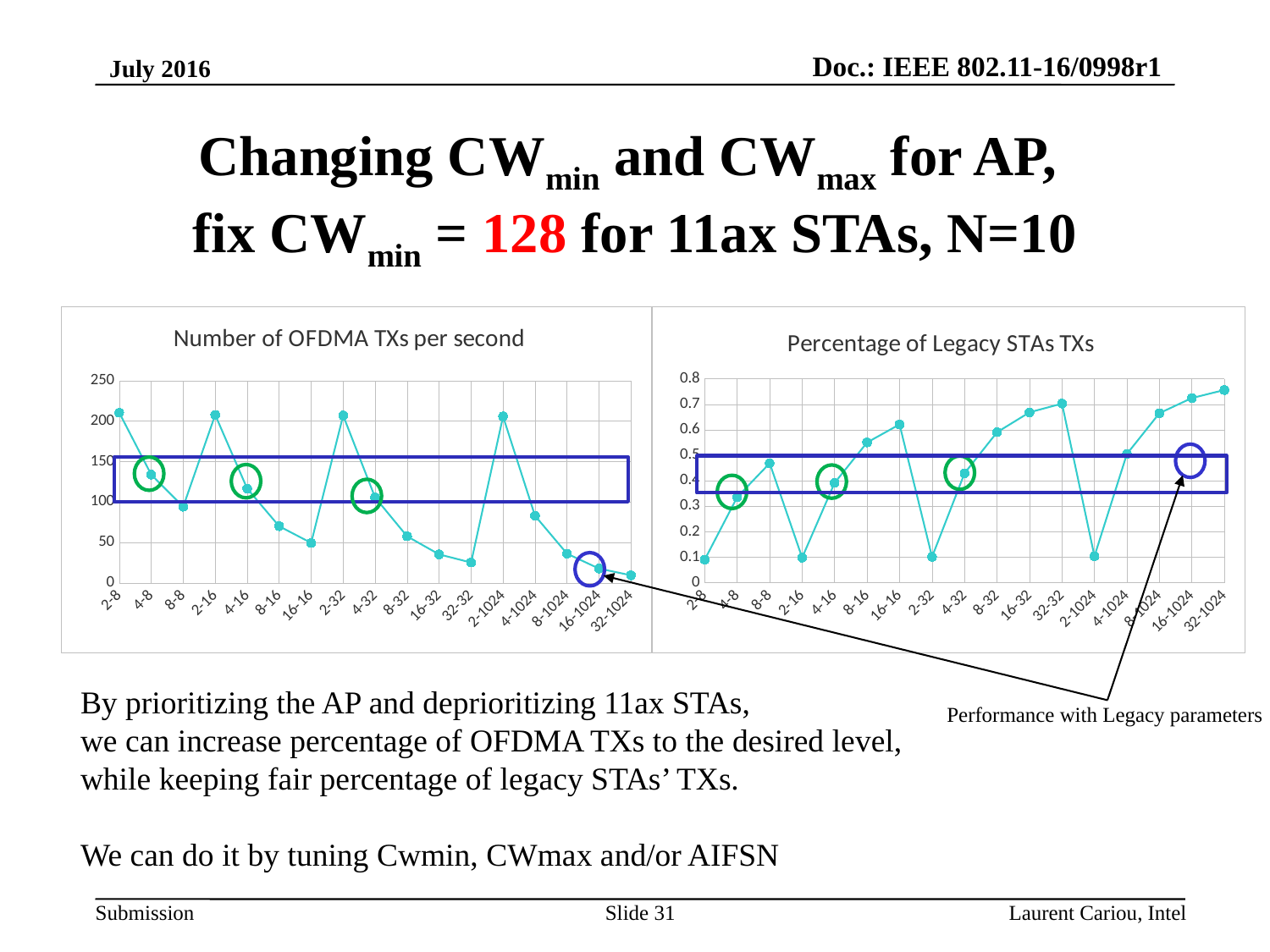
What is the highest tick value shown on the y axis of the 'Number of OFDMA TXs per second' chart? 250 In the 'Percentage of Legacy STAs TXs' chart, which is larger, the value for 4-16 or the value for 8-16? 8-16 In the 'Number of OFDMA TXs per second' chart, which is larger, the value for 4-8 or the value for 8-8? 4-8 In the 'Percentage of Legacy STAs TXs' chart, is the value for 2-32 greater or less than 0.2? less In the 'Number of OFDMA TXs per second' chart, which category has the lowest value? 32-1024 What kind of chart is the 'Number of OFDMA TXs per second' chart? line chart In the 'Number of OFDMA TXs per second' chart, is the value for 2-8 greater or less than 200? greater What is the title of the chart on the right side of the slide? Percentage of Legacy STAs TXs How many categories are shown on the x axis of the 'Percentage of Legacy STAs TXs' chart? 17